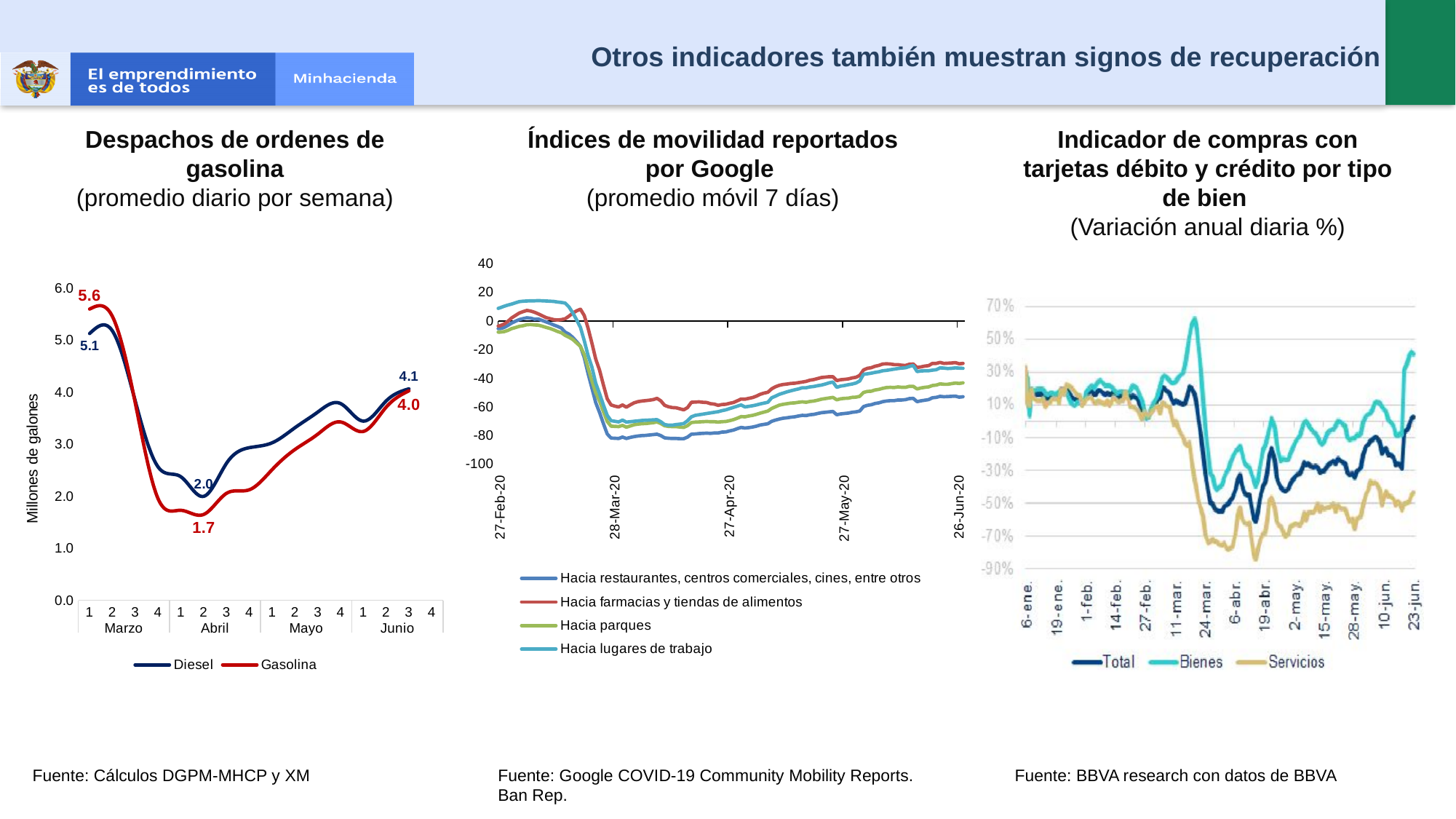
In the 'Despachos de ordenes de gasolina' chart, what is the labelled lowest value of the Gasolina series? 1.7 In the 'Despachos de ordenes de gasolina' chart, what is the labelled value of the Diesel series at the end of the period (Junio)? 4.1 In the 'Despachos de ordenes de gasolina' chart, what is the difference between the labelled minimum of Diesel (2.0) and the labelled minimum of Gasolina (1.7)? 0.3 What type of chart is the 'Despachos de ordenes de gasolina' chart? Line chart In the 'Despachos de ordenes de gasolina' chart, what is the labelled starting value of the Diesel series in week 1 of Marzo? 5.1 In the 'Índices de movilidad reportados por Google' chart, is the value of 'Hacia restaurantes, centros comerciales, cines, entre otros' around 28-Mar-20 greater or less than -60? less How many series does the legend of the 'Índices de movilidad reportados por Google' chart list? 4 In the 'Despachos de ordenes de gasolina' chart, what is the labelled starting value of the Gasolina series in week 1 of Marzo? 5.6 What is the y-axis label of the 'Despachos de ordenes de gasolina' chart? Millones de galones In the 'Despachos de ordenes de gasolina' chart, what is the difference between the Gasolina starting value (5.6) and its ending value (4.0)? 1.6 In the 'Despachos de ordenes de gasolina' chart, which series has the higher labelled value at the end of the period, Diesel or Gasolina? Diesel How many series does the legend of the 'Indicador de compras con tarjetas débito y crédito por tipo de bien' chart list? 3